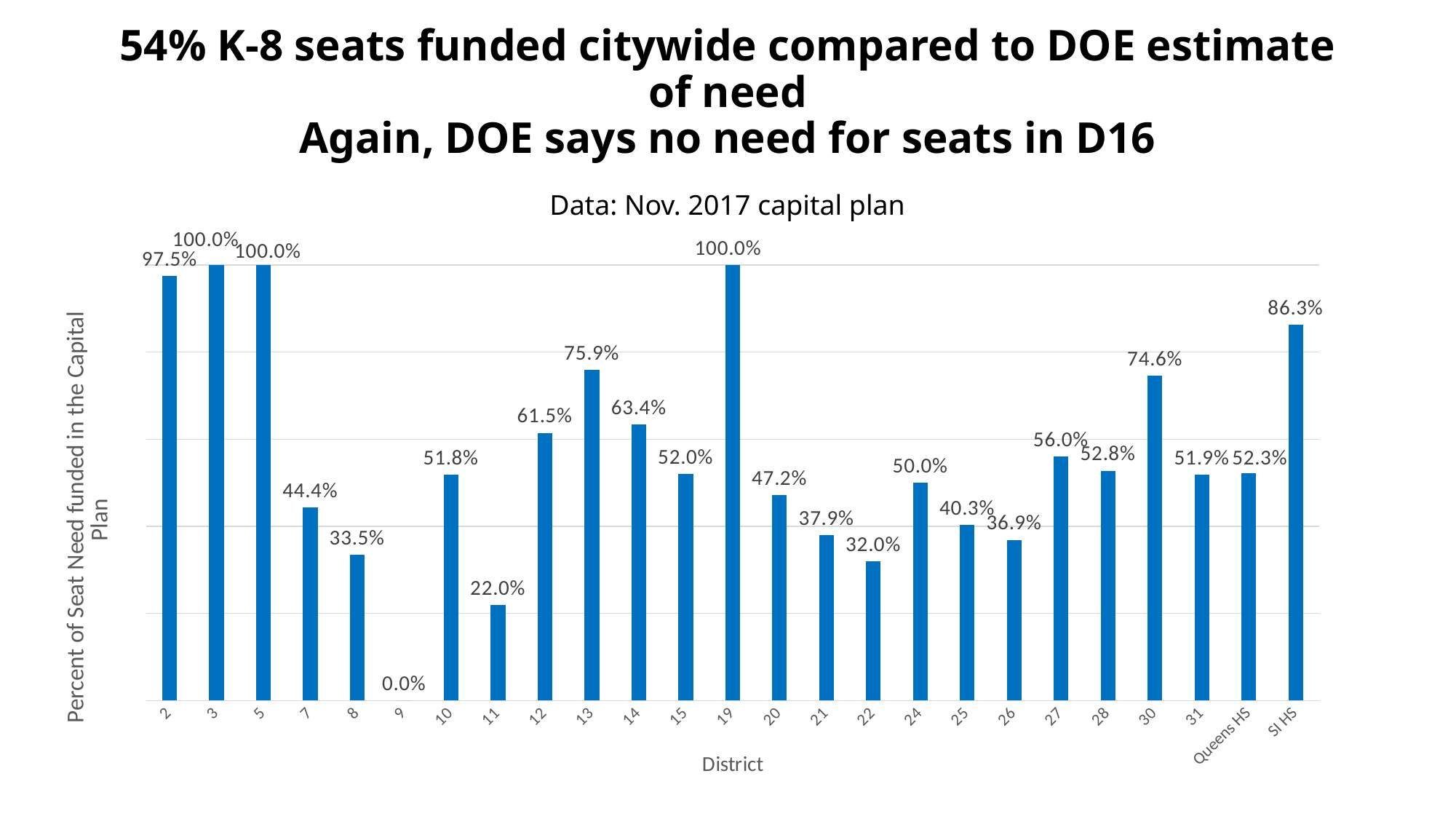
Which has a higher percent funded, District 7 or District 8? District 7 What percent of seat need is funded in the capital plan for District 11? 22.0% How many categories are shown on the x axis? 25 What is the title printed directly above the chart? Data: Nov. 2017 capital plan What kind of chart is shown on the slide? Bar chart Which district has the lowest percent of seat need funded? 9 What is the value shown for District 9? 0.0% Which has a higher percent funded, District 13 or District 30? District 13 What is the value shown for SI HS? 86.3% What percent of seat need is funded for District 27? 56.0% What is the difference between the values for District 2 and District 11? 75.5% What is the difference between the values for SI HS and Queens HS? 34.0%